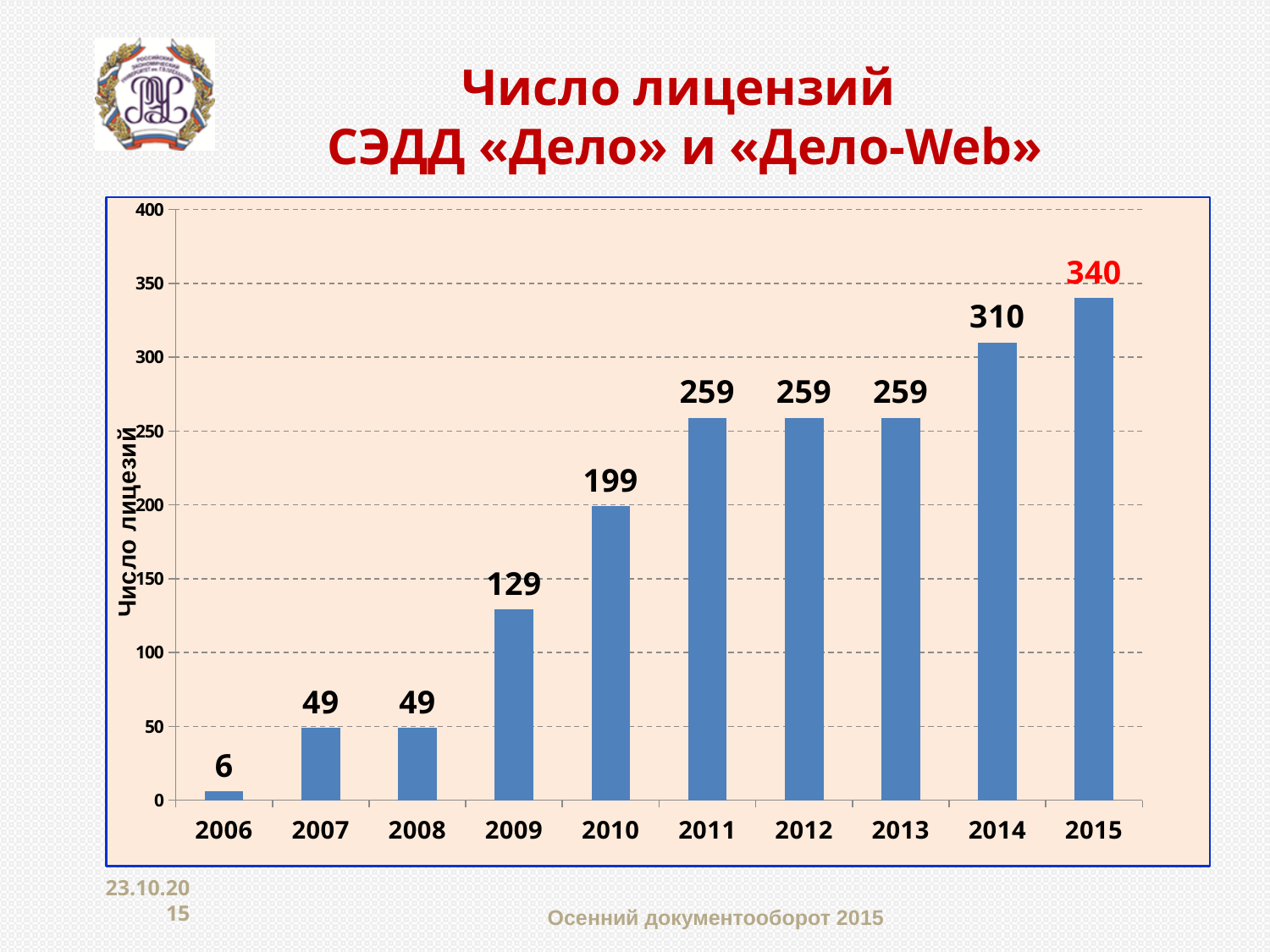
What is the difference between the number of licenses in 2015 and in 2014? 30 How many years are shown on the x axis? 10 What is the number of licenses in 2014? 310 Is the value for 2013 greater or less than 250? greater Which year has the lowest number of licenses? 2006 Which year has more licenses, 2010 or 2011? 2011 What is the label of the vertical axis? Число лицезий What kind of chart is shown on the slide? bar chart What is the number of licenses in 2006? 6 What is the number of licenses in 2010? 199 Which year has the highest number of licenses? 2015 What is the difference between the number of licenses in 2009 and in 2008? 80